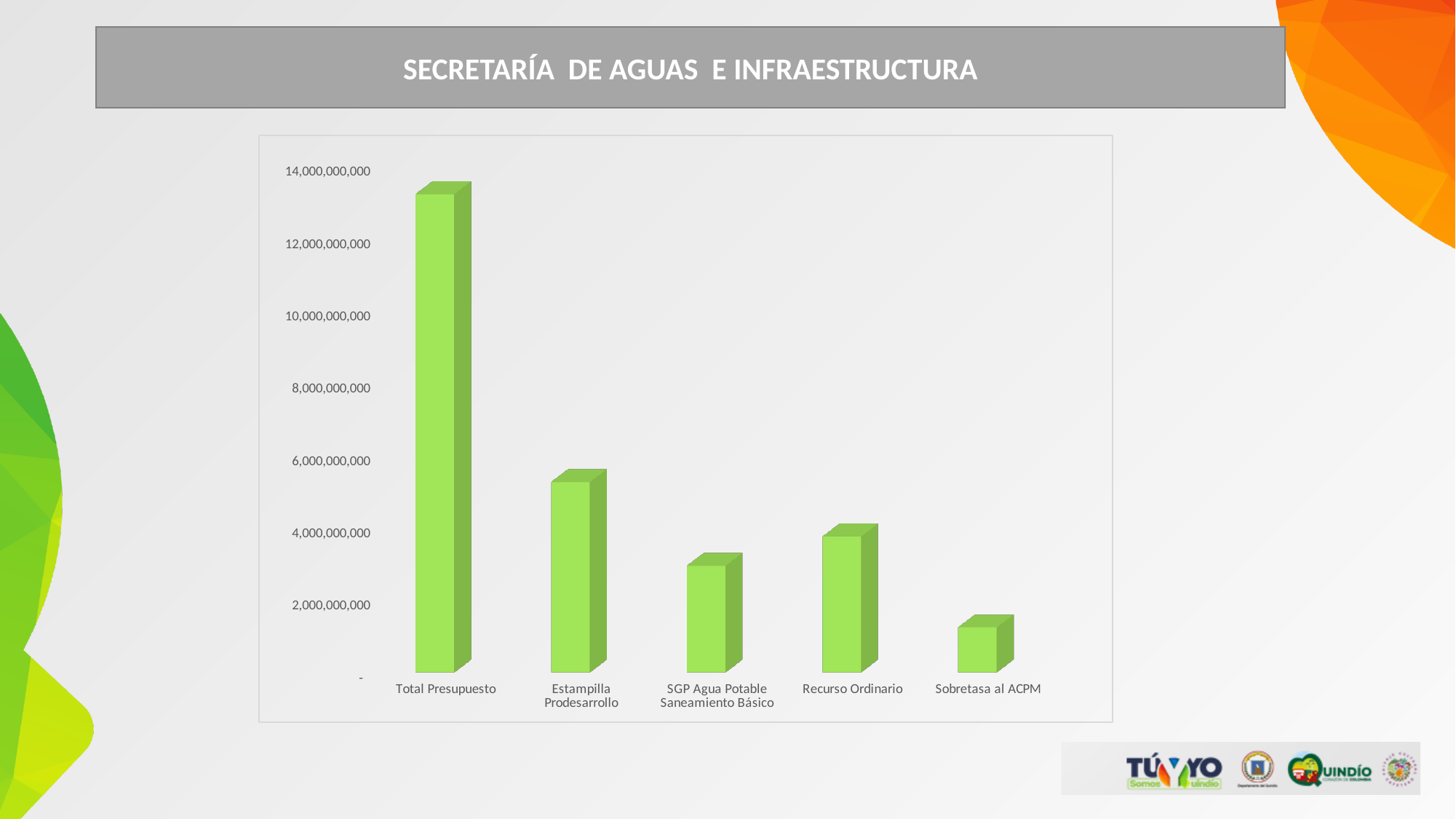
How many categories are plotted on the x axis of the chart? 5 Is the value for Sobretasa al ACPM greater or less than 2,000,000,000? less Which is larger, the value for SGP Agua Potable Saneamiento Básico or the value for Recurso Ordinario? Recurso Ordinario Which category has the lowest bar in the chart? Sobretasa al ACPM Which category has the highest bar in the chart? Total Presupuesto What kind of chart is shown on the slide? Bar chart Is the value for SGP Agua Potable Saneamiento Básico greater or less than 2,000,000,000? greater What is the title shown in the banner above the chart? SECRETARÍA DE AGUAS E INFRAESTRUCTURA Which is larger, the value for Estampilla Prodesarrollo or the value for Recurso Ordinario? Estampilla Prodesarrollo Is the value for Estampilla Prodesarrollo greater or less than 6,000,000,000? less What colour are the bars in the chart? Green